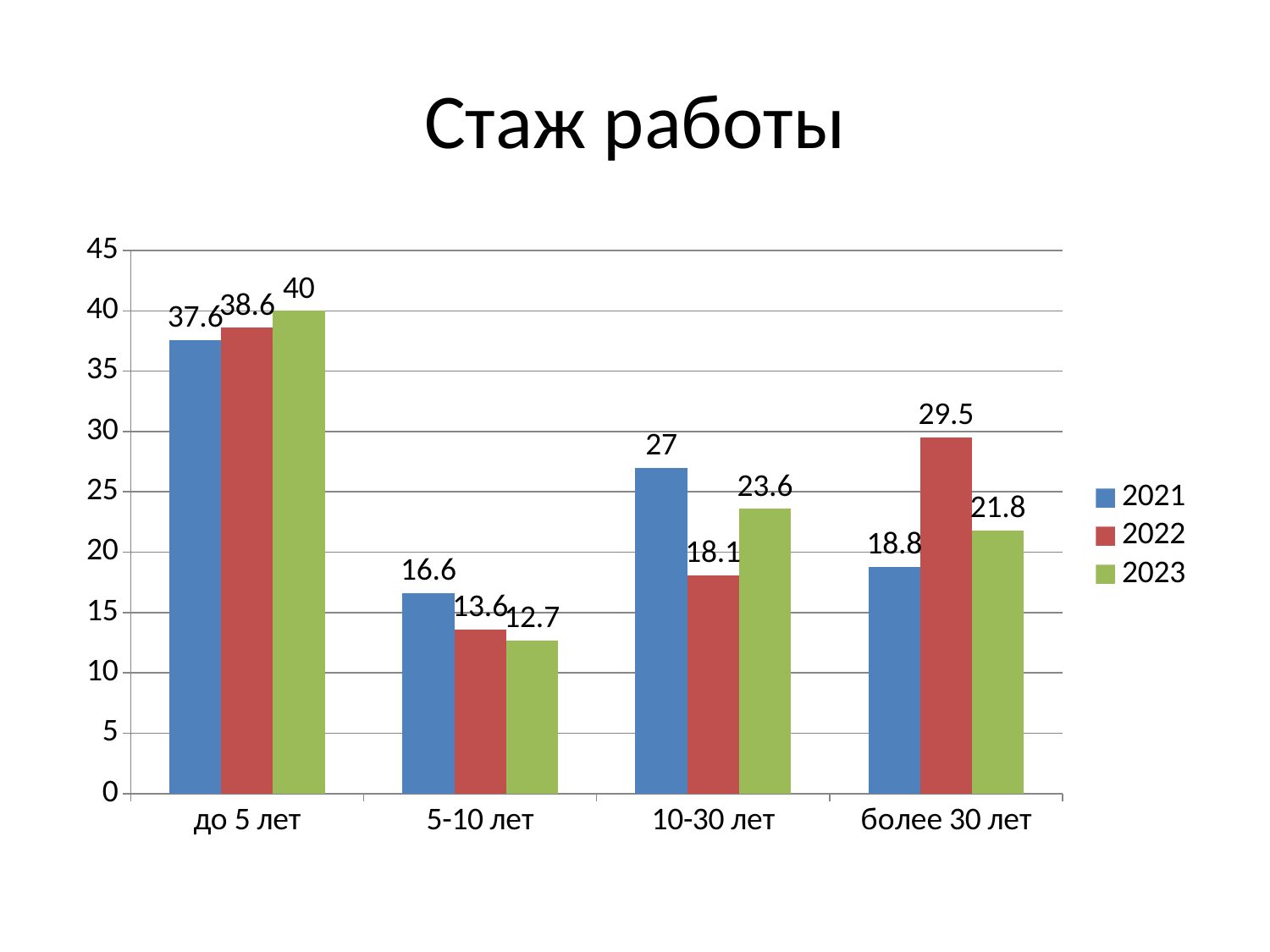
What is the value for 2022 in the 'более 30 лет' category? 29.5 Which category has the highest value for the 2021 series? до 5 лет Which category has the lowest value for the 2023 series? 5-10 лет What is the difference between the 2021 and 2022 values in the '10-30 лет' category? 8.9 What is the title of the chart? Стаж работы How many series does the legend list? 3 How many categories are shown on the x axis? 4 Is the value for 2022 in the '10-30 лет' category greater or less than 20? less In the 'более 30 лет' category, which series has the larger value, 2021 or 2023? 2023 What is the value for 2023 in the 'до 5 лет' category? 40 What kind of chart is shown on the slide? bar chart What is the value for 2021 in the '5-10 лет' category? 16.6